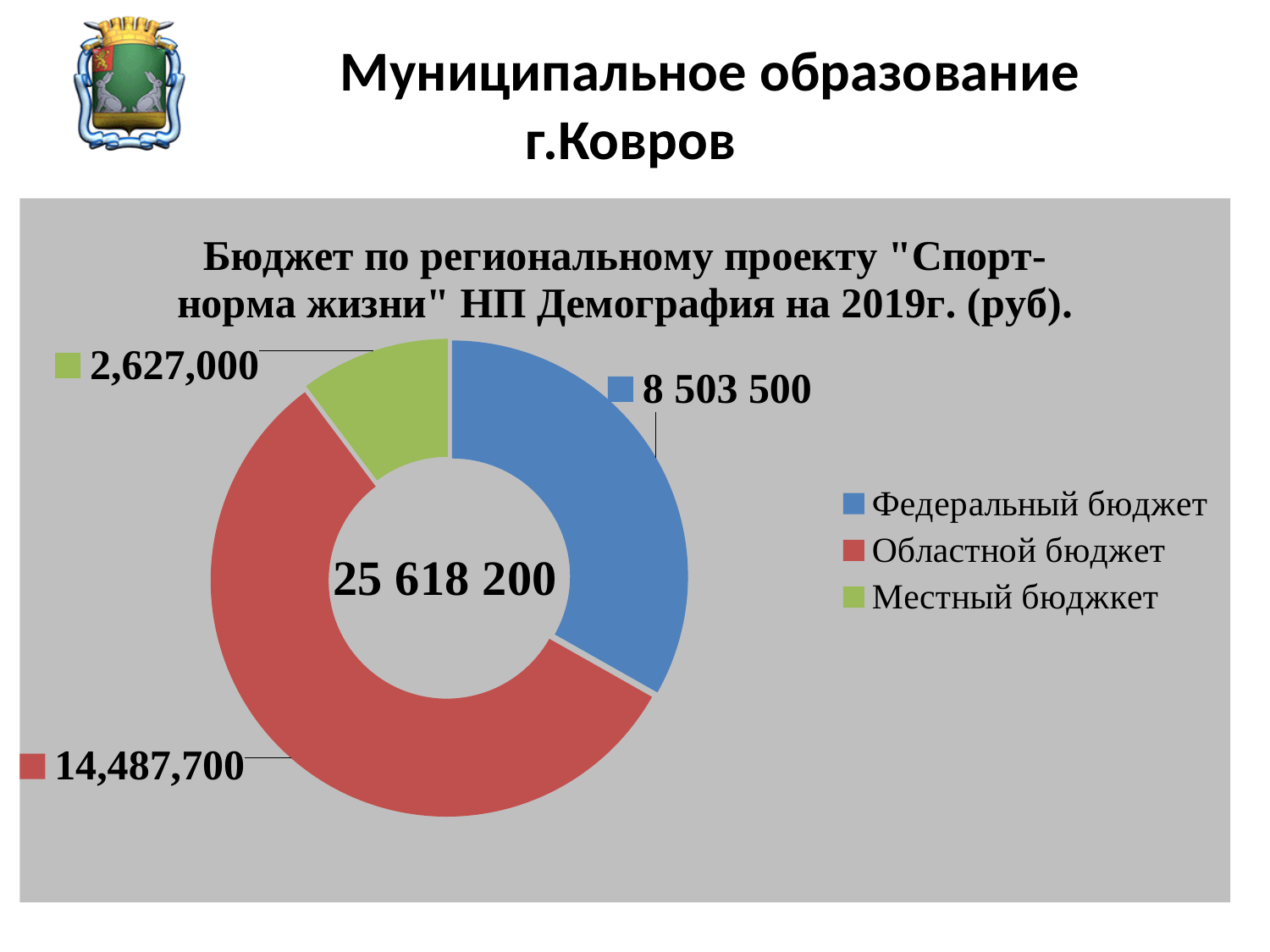
What is the value for Областной бюджет? 14,487,700 Which budget source has the smallest value? Местный бюджкет What is the value for Федеральный бюджет? 8 503 500 Which is larger, Федеральный бюджет or Местный бюджкет? Федеральный бюджет What colour represents Областной бюджет in the chart? Red What is the difference between Федеральный бюджет and Местный бюджкет? 5,876,500 What is the difference between Областной бюджет and Федеральный бюджет? 5,984,200 Which budget source has the largest value? Областной бюджет How many slices does the chart have? 3 What total is shown in the centre of the doughnut chart? 25 618 200 What is the value for Местный бюджкет? 2,627,000 What kind of chart is shown on the slide? Doughnut (pie) chart